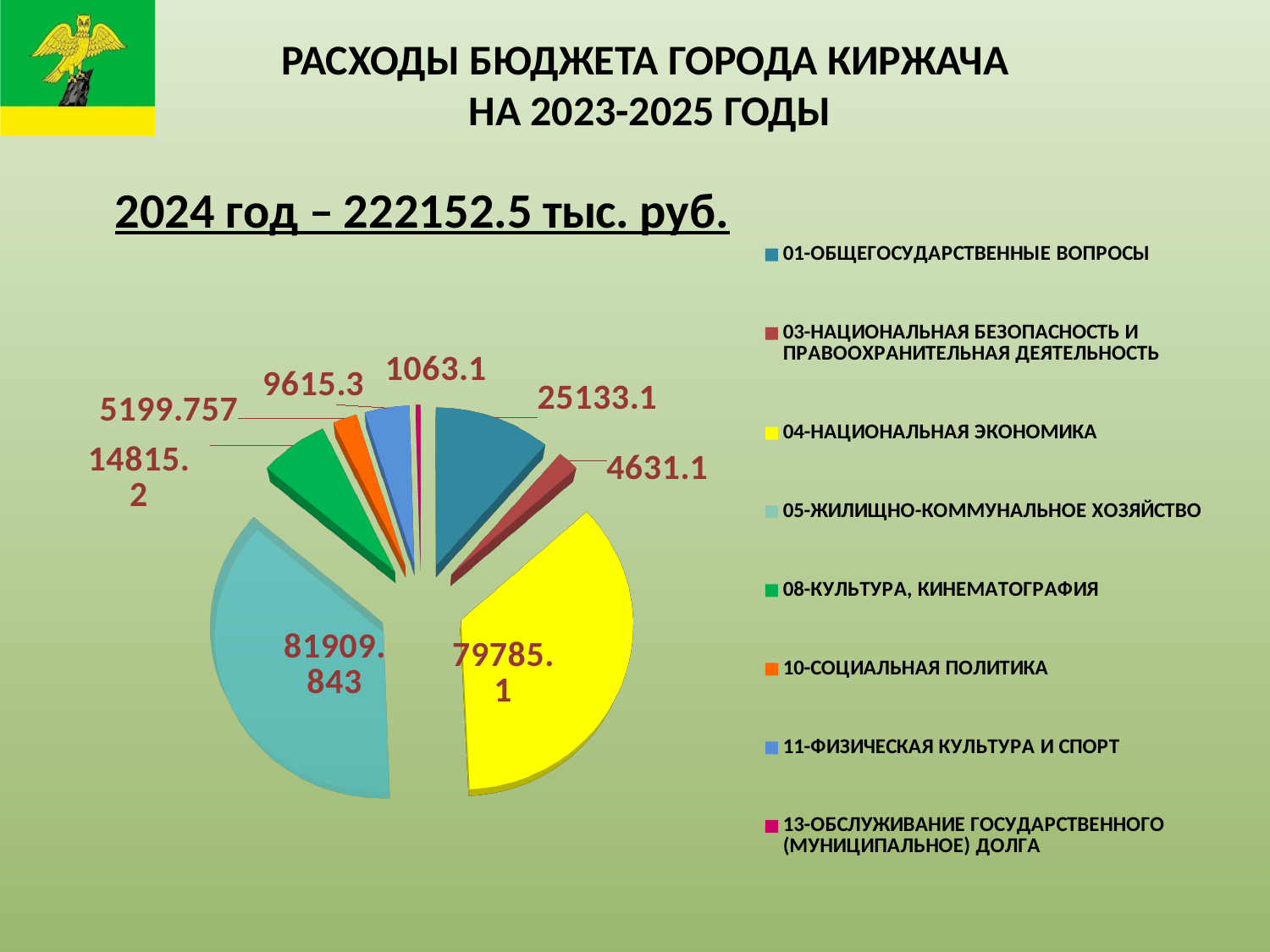
What type of chart is shown on the slide? Pie chart How many categories does the legend list? 8 Which category has the smallest slice of the pie? 13-ОБСЛУЖИВАНИЕ ГОСУДАРСТВЕННОГО (МУНИЦИПАЛЬНОЕ) ДОЛГА Which is larger, the value for 11-ФИЗИЧЕСКАЯ КУЛЬТУРА И СПОРТ or the value for 10-СОЦИАЛЬНАЯ ПОЛИТИКА? 11-ФИЗИЧЕСКАЯ КУЛЬТУРА И СПОРТ What total amount for 2024 is stated above the chart? 222152.5 тыс. руб. What is the difference between the values for 05-ЖИЛИЩНО-КОММУНАЛЬНОЕ ХОЗЯЙСТВО and 04-НАЦИОНАЛЬНАЯ ЭКОНОМИКА? 2124.743 What is the value for 08-КУЛЬТУРА, КИНЕМАТОГРАФИЯ? 14815.2 What is the value for 10-СОЦИАЛЬНАЯ ПОЛИТИКА? 5199.757 Which category has the largest slice of the pie? 05-ЖИЛИЩНО-КОММУНАЛЬНОЕ ХОЗЯЙСТВО What is the value for 04-НАЦИОНАЛЬНАЯ ЭКОНОМИКА? 79785.1 What is the value for 01-ОБЩЕГОСУДАРСТВЕННЫЕ ВОПРОСЫ? 25133.1 What is the difference between the values for 01-ОБЩЕГОСУДАРСТВЕННЫЕ ВОПРОСЫ and 03-НАЦИОНАЛЬНАЯ БЕЗОПАСНОСТЬ И ПРАВООХРАНИТЕЛЬНАЯ ДЕЯТЕЛЬНОСТЬ? 20502